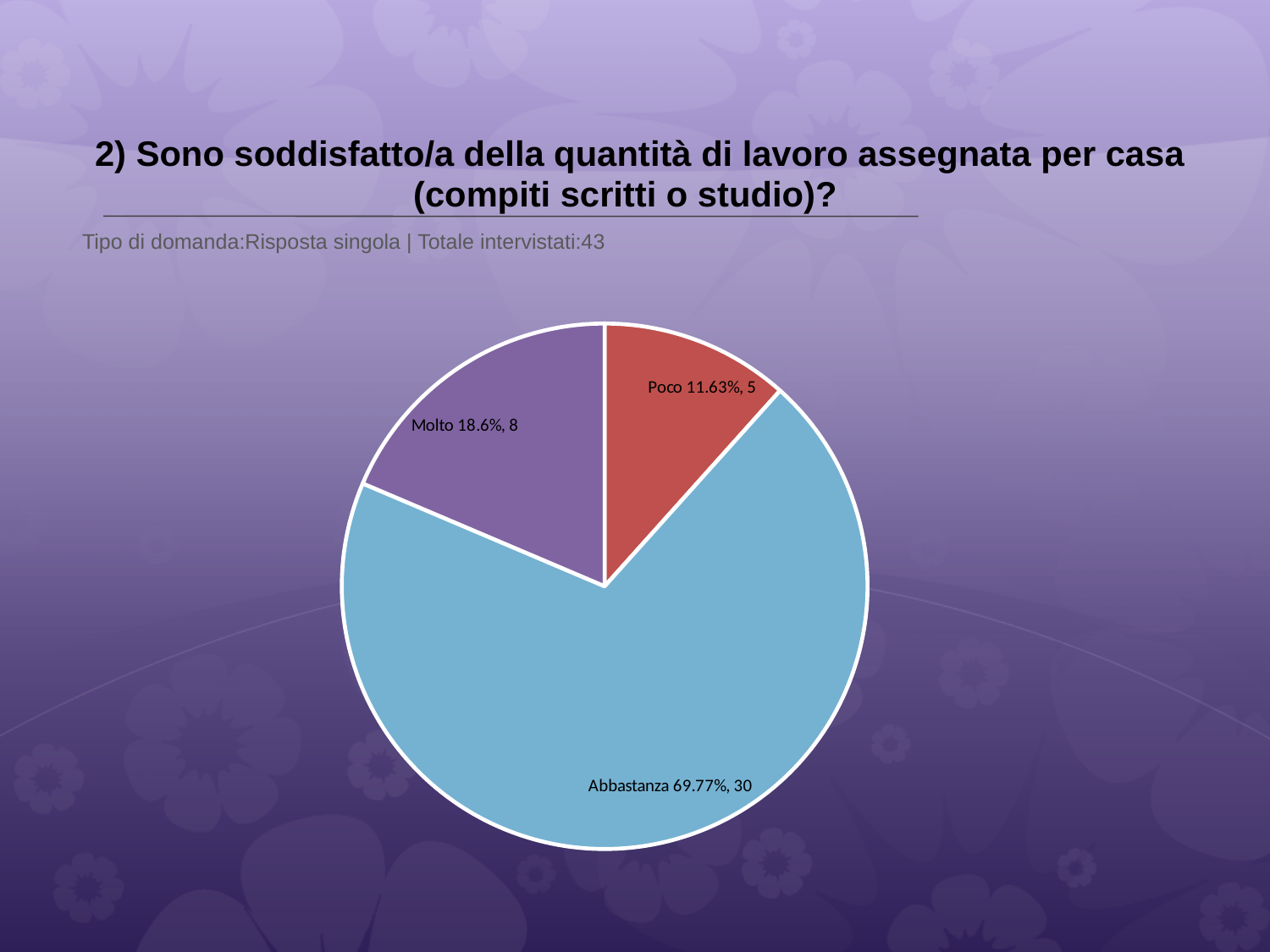
How many slices does the pie chart have? 3 What kind of chart is shown on the slide? pie chart Which category has the smallest slice? Poco What colour is the 'Abbastanza' slice? light blue Which has more respondents, 'Molto' or 'Poco'? Molto What percentage share does the 'Poco' slice have? 11.63% How many respondents answered 'Poco'? 5 How many respondents answered 'Molto'? 8 What is the total number of respondents across all slices? 43 Which category has the largest slice? Abbastanza What percentage share does the 'Abbastanza' slice have? 69.77% What is the difference in respondent count between 'Abbastanza' and 'Molto'? 22